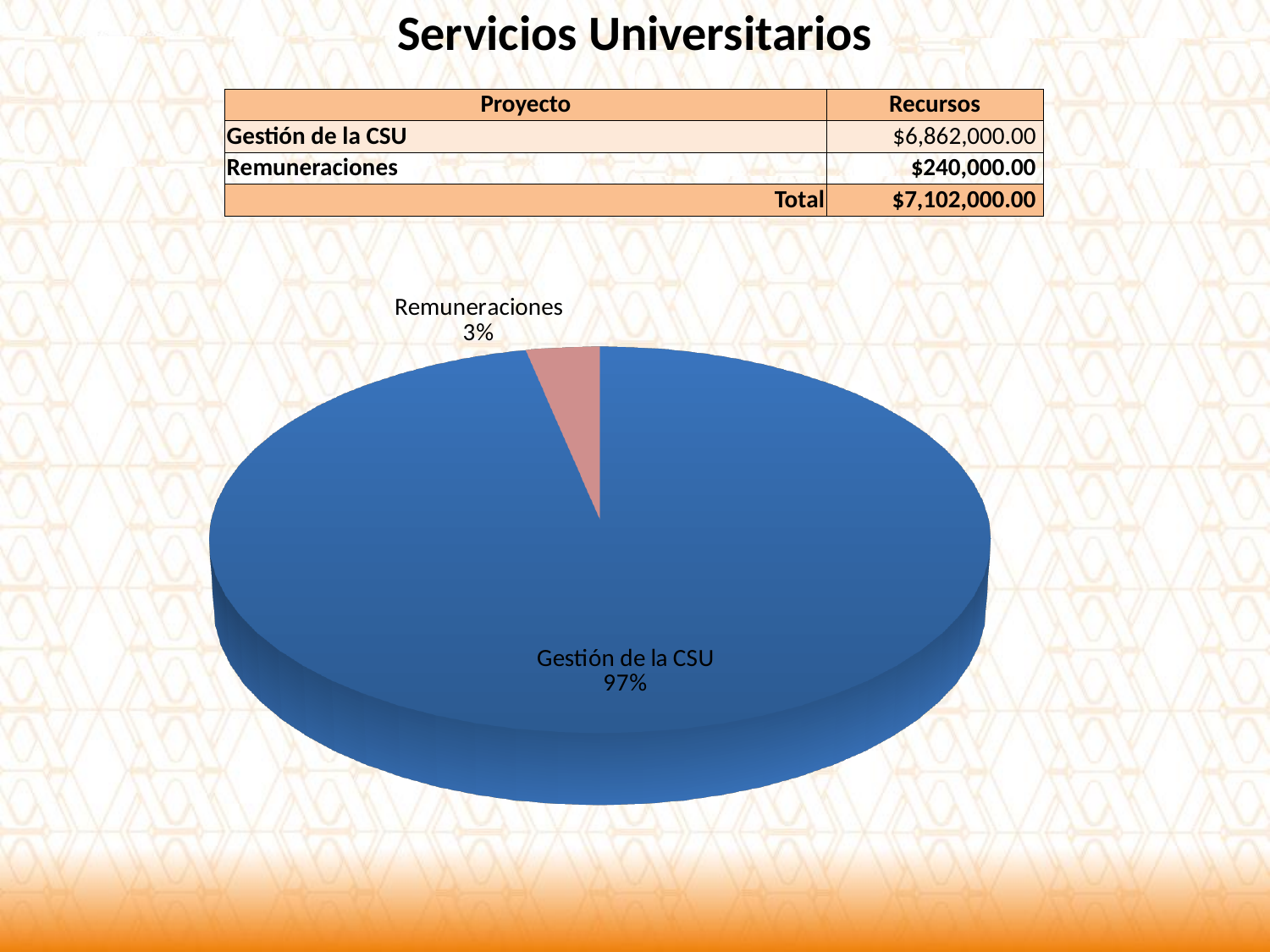
Which is larger in the pie chart, Gestión de la CSU or Remuneraciones? Gestión de la CSU What share of the pie does Gestión de la CSU represent? 97% What is the title of the slide containing the pie chart? Servicios Universitarios Which slice of the pie chart is the smallest? Remuneraciones What colour is the Gestión de la CSU slice in the pie chart? blue What share of the pie does Remuneraciones represent? 3% What kind of chart is shown on the slide? pie chart Which slice of the pie chart is the largest? Gestión de la CSU How many slices does the pie chart have? 2 What is the difference in percentage points between the Gestión de la CSU slice and the Remuneraciones slice? 94